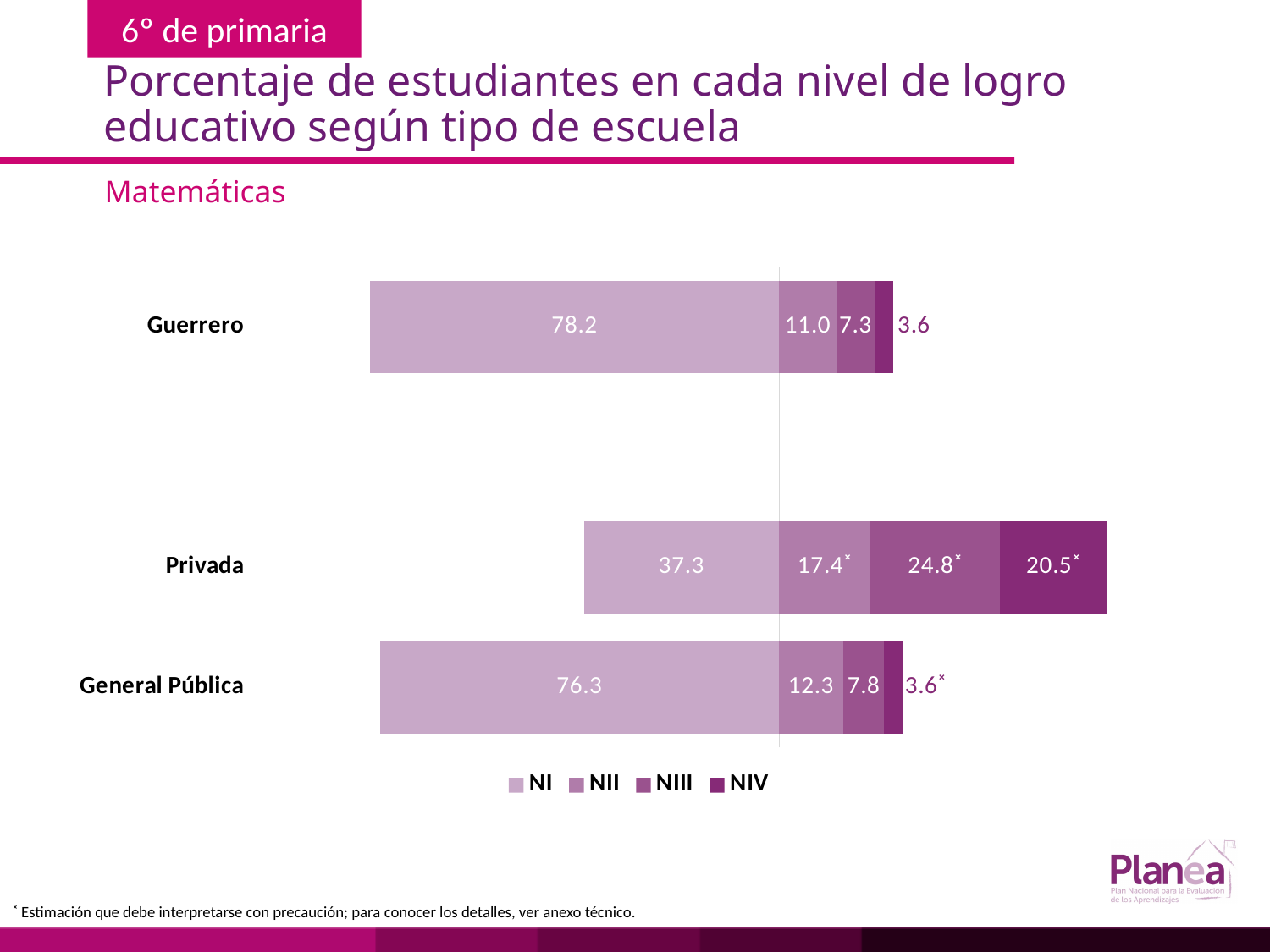
What kind of chart is shown on the slide? Stacked bar chart What is the NI value for Guerrero? 78.2 What is the NIV value for Privada? 20.5 How many school types are shown in the chart? 3 What is the NIII value for Privada? 24.8 Which is larger, the NIII value for Privada or the NIII value for Guerrero? Privada What is the difference between the NI values for Guerrero and General Pública? 1.9 Which school type has the highest NI value? Guerrero Which school type has the lowest NI value? Privada How many series does the legend list? 4 What is the total of the stacked bar for Privada? 100.0 What is the NII value for General Pública? 12.3